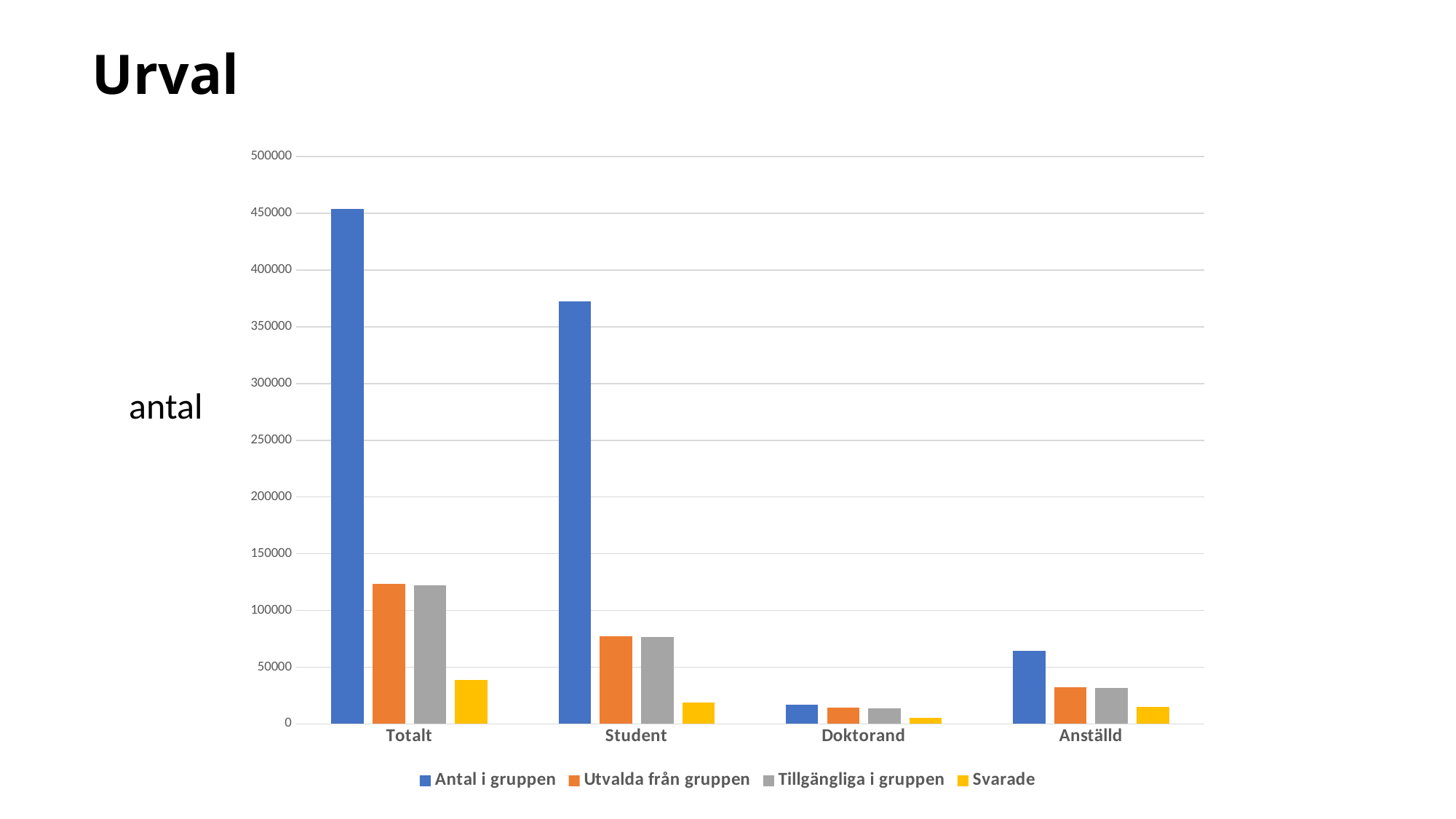
Is the value for Antal i gruppen in Anställd greater or less than 50000? greater What is the title of the slide? Urval Is the value for Antal i gruppen in Student greater or less than 400000? less Which category has the highest value for Antal i gruppen? Totalt Which category has the lowest value for Antal i gruppen? Doktorand How many series does the legend list? 4 Which is larger: Svarade for Totalt or Svarade for Doktorand? Totalt What kind of chart is shown on the slide? bar chart Is the value for Utvalda från gruppen in Totalt greater or less than 100000? greater How many categories are shown on the x axis? 4 Which is larger: Antal i gruppen for Student or Antal i gruppen for Anställd? Student